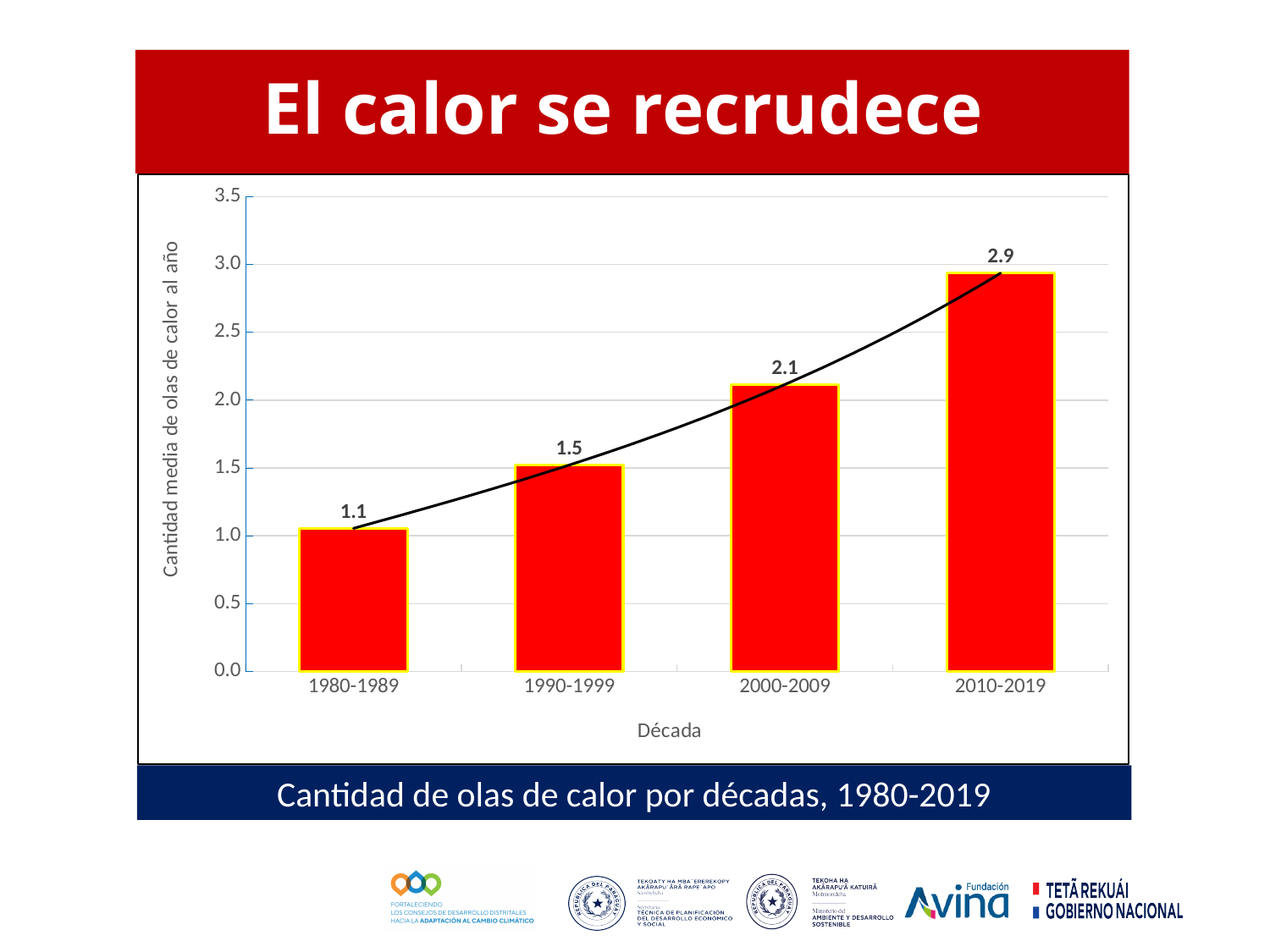
What is the value for the 2010-2019 decade? 2.9 Do the values rise or fall from 1980-1989 to 2010-2019? rise What is the value for the 2000-2009 decade? 2.1 Which is larger, the value for 1990-1999 or the value for 2000-2009? 2000-2009 What is the difference between the values for 2000-2009 and 1990-1999? 0.6 What is the label of the x axis? Década What is the difference between the values for 2010-2019 and 1980-1989? 1.8 What kind of chart is shown on the slide? bar chart Which decade has the lowest average number of heat waves per year? 1980-1989 What is the value for the 1980-1989 decade? 1.1 Which decade has the highest average number of heat waves per year? 2010-2019 How many decades are shown on the x axis? 4